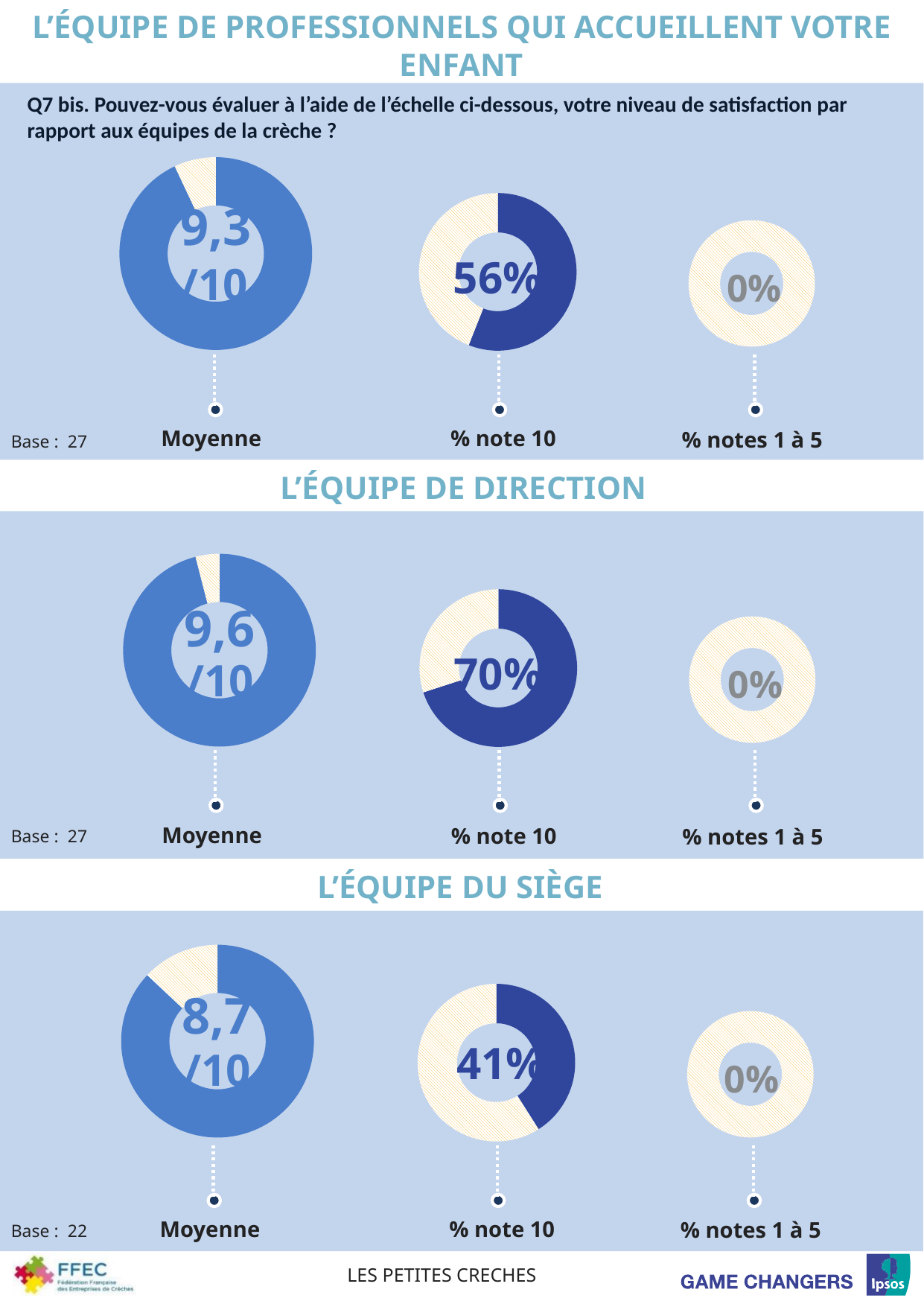
Which of the three sections has the lowest Moyenne? L'équipe du siège Which is larger: the % note 10 value in the top section (L'équipe de professionnels) or the % note 10 value in the L'équipe du siège section? The top section (L'équipe de professionnels), 56% In the L'équipe de direction section, what is the Moyenne shown in the first donut chart? 9,6/10 In the L'équipe du siège section, what is the Moyenne shown in the first donut chart? 8,7/10 In the top section (L'équipe de professionnels qui accueillent votre enfant), what is the Moyenne shown in the first donut chart? 9,3/10 What is the difference between the % note 10 value for L'équipe de direction and the % note 10 value for L'équipe du siège? 29% In the L'équipe du siège section, what is the % note 10 value? 41% In the L'équipe de direction section, what is the % note 10 value? 70% In the top section (L'équipe de professionnels qui accueillent votre enfant), what is the % note 10 value? 56% Which of the three sections has the highest % note 10 value? L'équipe de direction What kind of chart is used to display the values on this slide? Donut (pie) chart In the L'équipe du siège section, what is the % notes 1 à 5 value? 0%